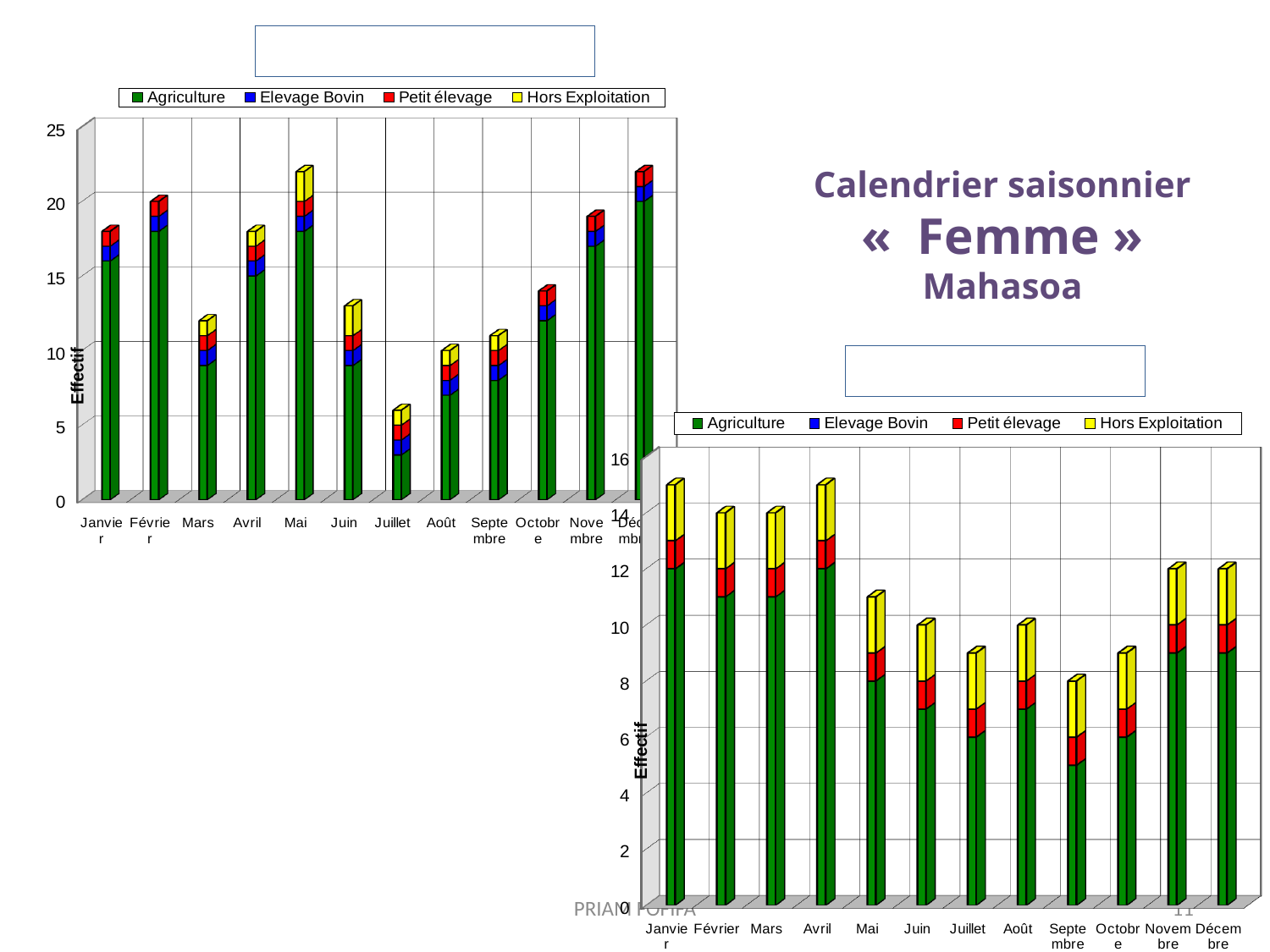
In the bottom-right chart, is the total value for Janvier greater or less than 12? greater Which series is shown in yellow in the legend of the top-left chart? Hors Exploitation In the bottom-right chart, is the total value for Septembre greater or less than 10? less In the bottom-right chart, which month has the larger total bar, Novembre or Juin? Novembre In the top-left chart, which month has the lowest total bar? Juillet In the top-left chart, is the total value for Mai greater or less than 20? greater What kind of chart is the chart in the top-left of the slide? Stacked bar chart In the bottom-right chart, which month has the lowest total bar? Septembre In the top-left chart, which month has the larger total bar, Février or Mars? Février How many months are shown on the x axis of the bottom-right chart? 12 How many series does the legend of the bottom-right chart list? 4